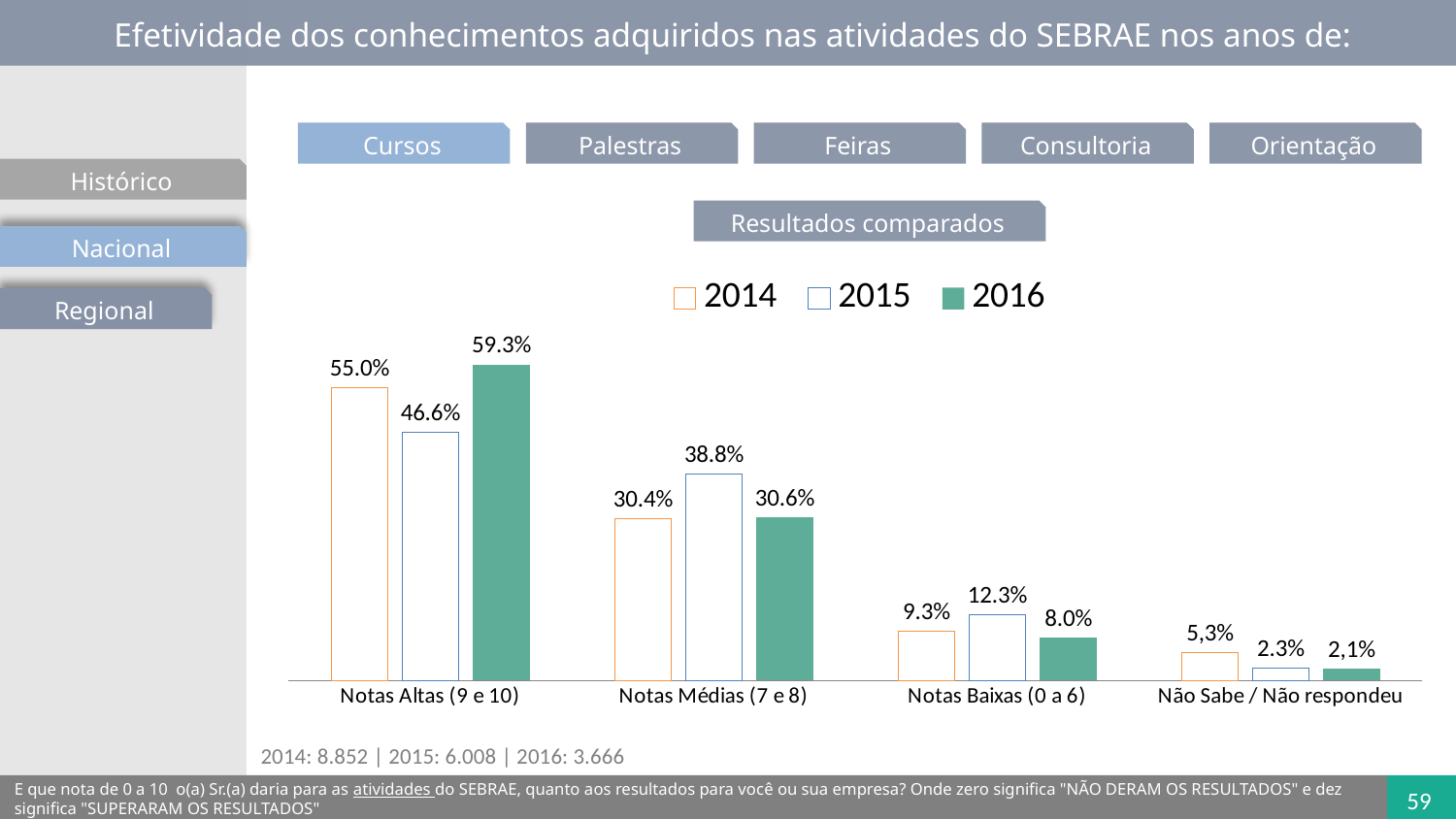
How many series does the legend list? 3 How many categories are shown on the x axis? 4 Which category has the highest value for 2016? Notas Altas (9 e 10) Which category has the lowest value for 2015? Não Sabe / Não respondeu Which series is shown with solid green bars in the legend? 2016 What is the value for 2014 in the Notas Baixas (0 a 6) category? 9.3% What is the value for 2016 in the Notas Altas (9 e 10) category? 59.3% What is the value for 2015 in the Notas Médias (7 e 8) category? 38.8% What is the value for 2014 in the Não Sabe / Não respondeu category? 5,3% In the Notas Baixas (0 a 6) category, which is larger, the 2015 value or the 2016 value? 2015 What is the difference between the 2016 and 2015 values in the Notas Altas (9 e 10) category? 12.7% What kind of chart is shown on the slide? bar chart